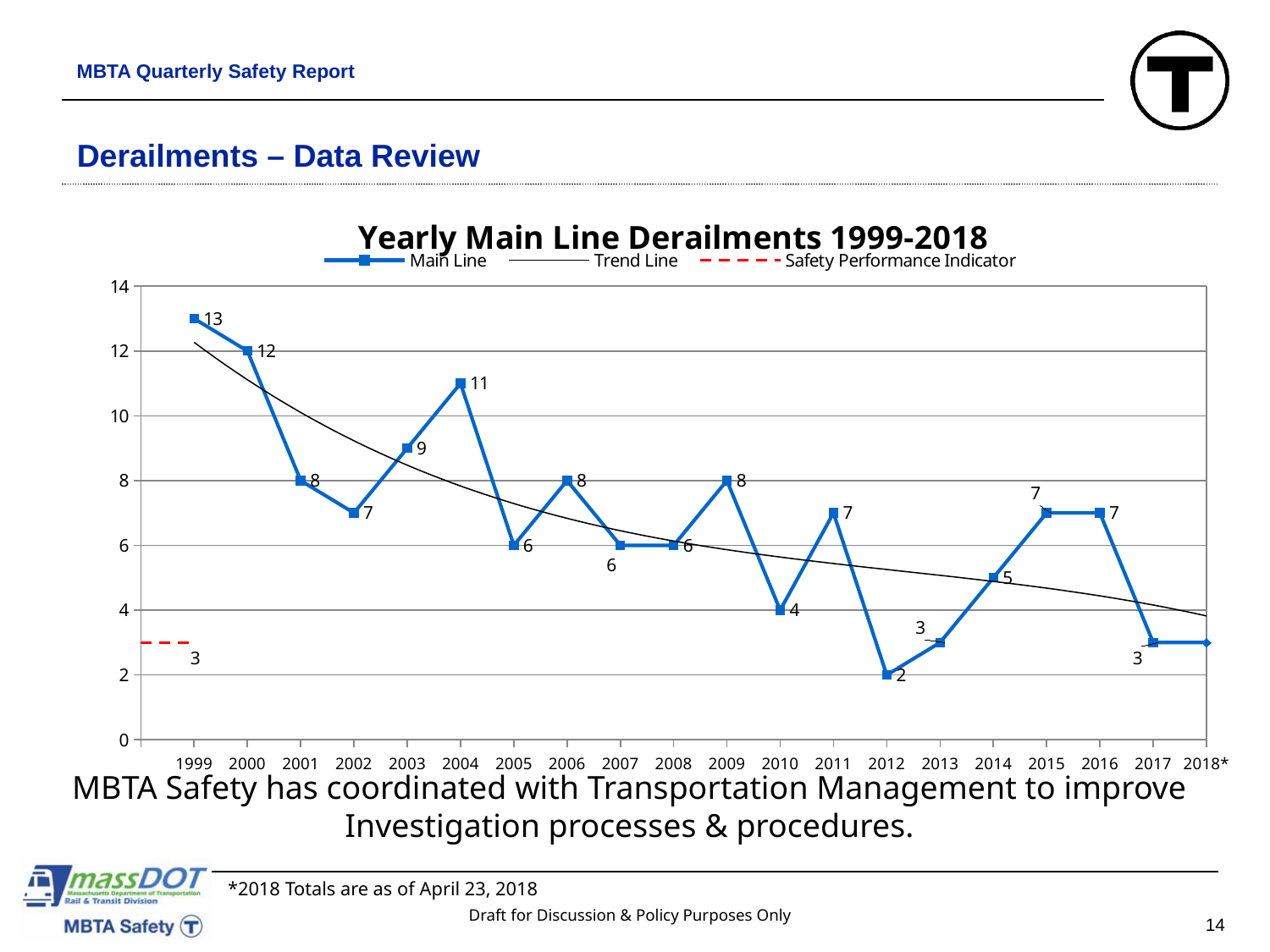
What is the difference between the Main Line values for 1999 and 2000? 1 Does the Main Line series generally rise or fall from 1999 to 2017? fall What is the title of the chart? Yearly Main Line Derailments 1999-2018 What value is labelled for the Safety Performance Indicator? 3 How many years are shown on the x axis? 20 Which year has the highest Main Line value? 1999 What is the Main Line value for 2012? 2 How many series does the legend list? 3 What is the Main Line value for 2004? 11 What type of chart is shown on the slide? line chart Which year has a larger Main Line value, 2003 or 2010? 2003 Which year has the lowest Main Line value? 2012